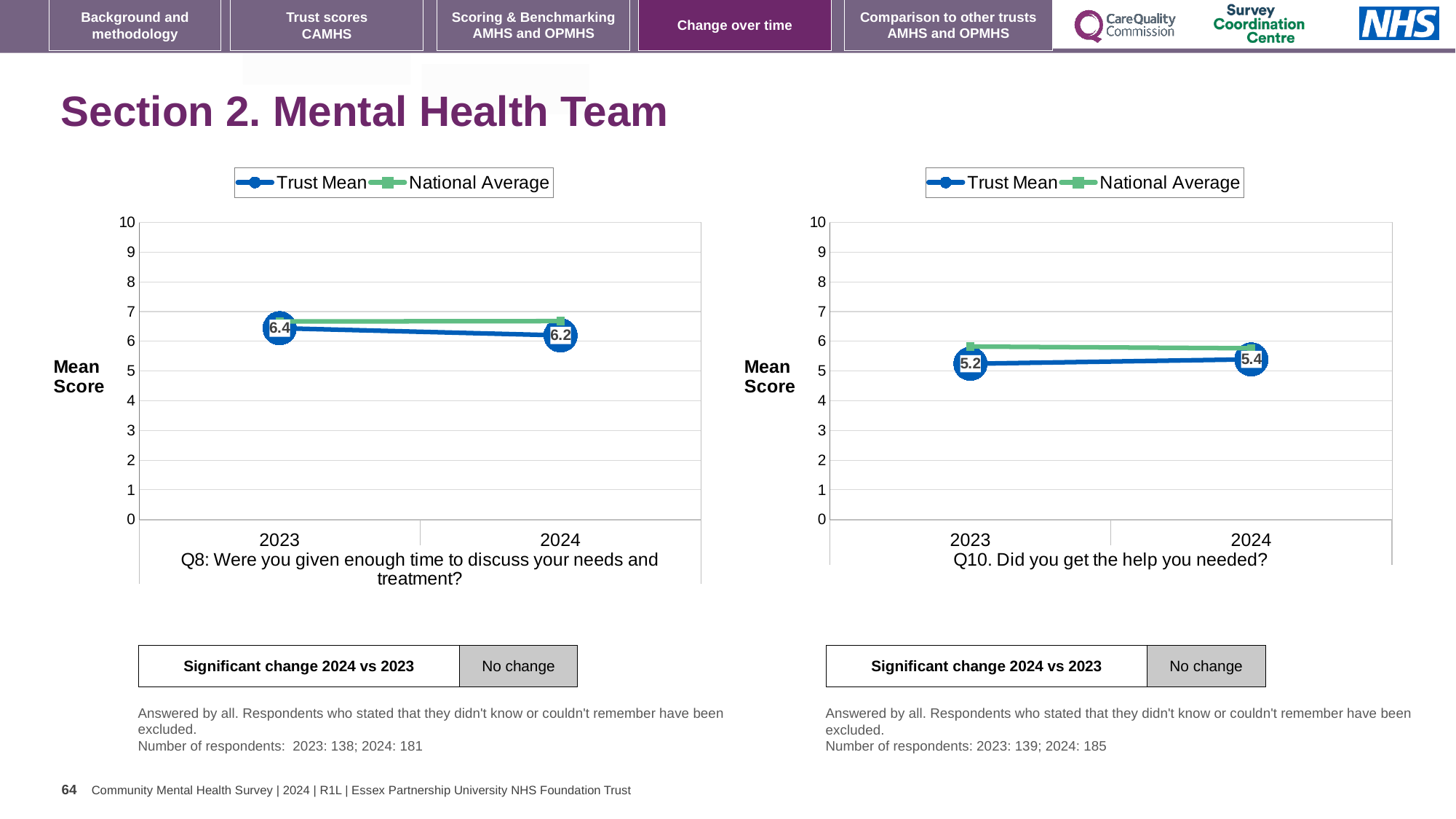
In the Q10 chart (right), what is the Trust Mean score for 2023? 5.2 In the Q8 chart (left), is the National Average value for 2024 greater or less than 6? greater What kind of chart is the Q8 chart (left)? line chart In the Q8 chart (left), what is the Trust Mean score for 2023? 6.4 In the Q8 chart (left), by how much did the Trust Mean change from 2023 to 2024? 0.2 How many years are shown on the x axis of the Q10 chart (right)? 2 In the Q10 chart (right), does the Trust Mean rise or fall from 2023 to 2024? rise In the Q8 chart (left), does the Trust Mean rise or fall from 2023 to 2024? fall In the Q10 chart (right), is the Trust Mean or the National Average higher in 2023? National Average In the Q8 chart (left), what is the Trust Mean score for 2024? 6.2 In the Q10 chart (right), what is the Trust Mean score for 2024? 5.4 How many series does the legend of the Q10 chart (right) list? 2